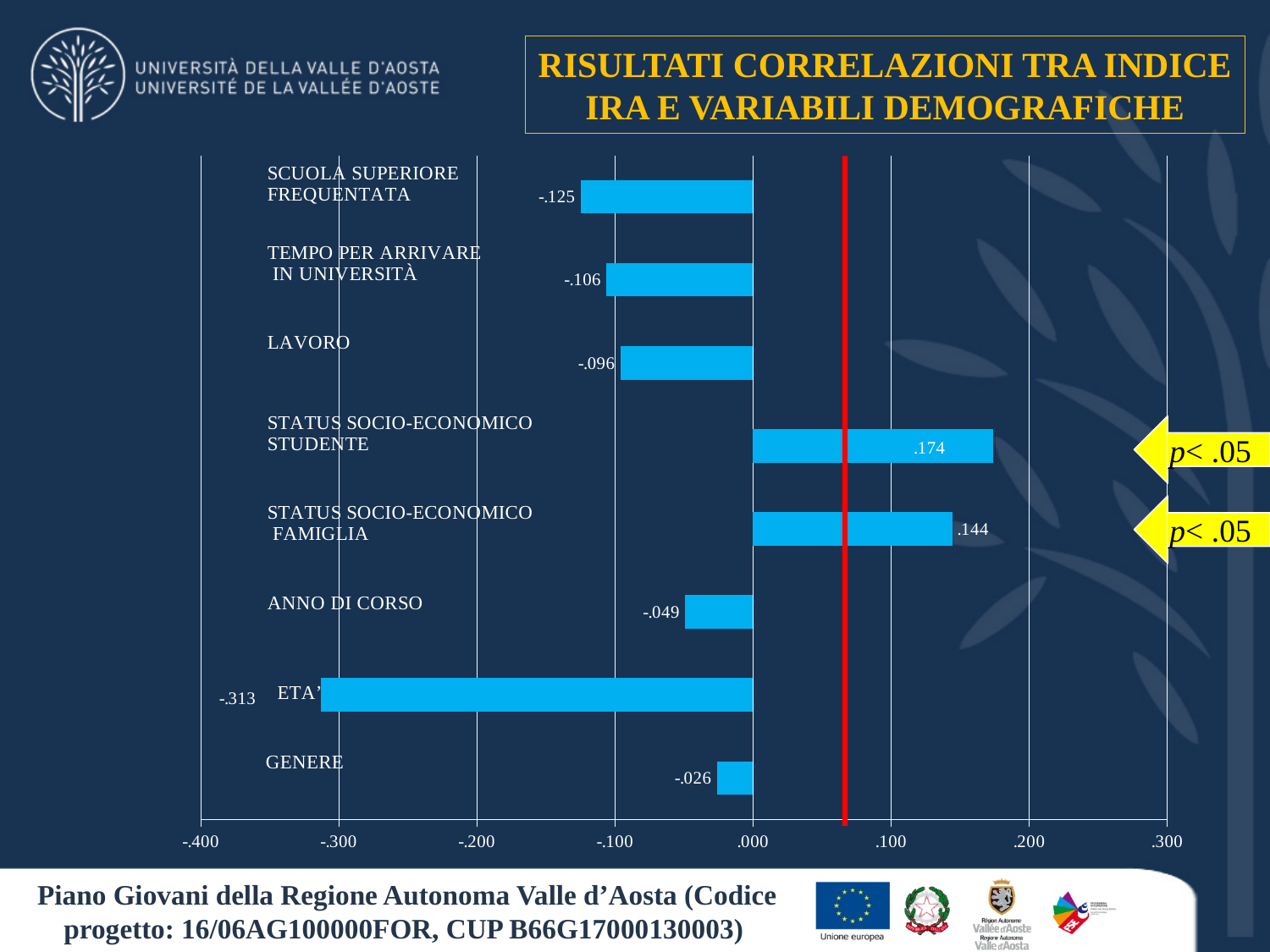
What is the value shown for STATUS SOCIO-ECONOMICO STUDENTE? .174 What is the correlation value shown for ETA'? -.313 What is the value shown for LAVORO? -.096 What kind of chart is shown on the slide? Bar chart Which category has the highest value in the chart? STATUS SOCIO-ECONOMICO STUDENTE What is the difference between the values for STATUS SOCIO-ECONOMICO STUDENTE and STATUS SOCIO-ECONOMICO FAMIGLIA? .030 What is the value shown for GENERE? -.026 Is the value for ETA' greater or less than -.300? less How many categories are plotted in the chart? 8 What is the title of the chart on the slide? RISULTATI CORRELAZIONI TRA INDICE IRA E VARIABILI DEMOGRAFICHE Which has a larger value, SCUOLA SUPERIORE FREQUENTATA or TEMPO PER ARRIVARE IN UNIVERSITÀ? TEMPO PER ARRIVARE IN UNIVERSITÀ Which category has the lowest value in the chart? ETA'